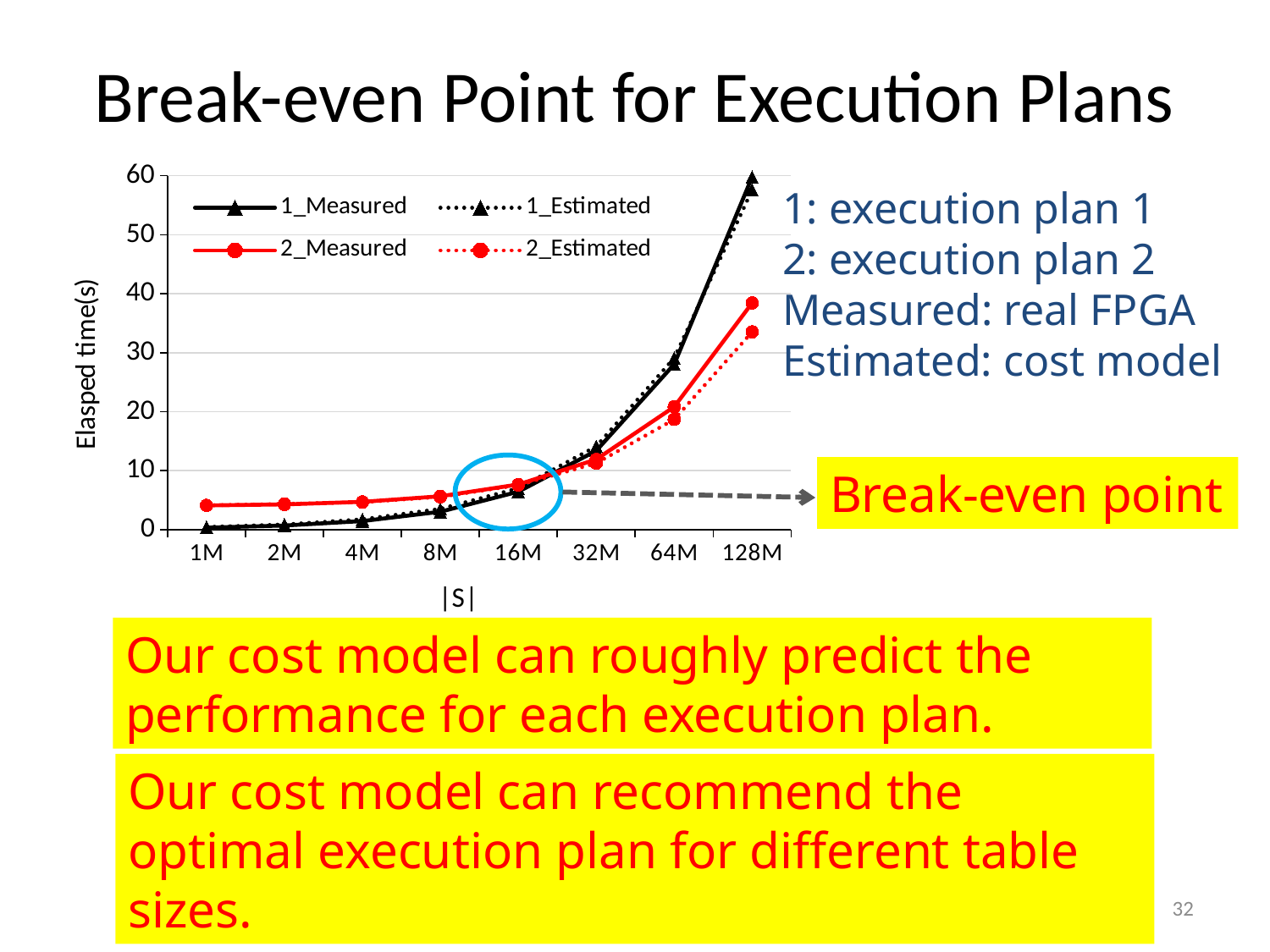
How many |S| categories are shown along the x axis of the chart? 8 How many series does the chart's legend list? 4 Do the 1_Measured values rise or fall as |S| increases along the x axis? rise At |S| = 128M, which series has the larger value, 1_Measured or 2_Measured? 1_Measured What kind of chart is shown on the slide? line chart What is the label on the y axis of the chart? Elasped time(s) Is the 2_Measured value at |S| = 128M greater or less than 30? greater Is the 1_Measured value at |S| = 128M greater or less than 50? greater At |S| = 1M, which series has the larger value, 1_Measured or 2_Measured? 2_Measured Is the 2_Measured value at |S| = 1M greater or less than 10? less At which |S| value does the 1_Measured series reach its highest elapsed time? 128M